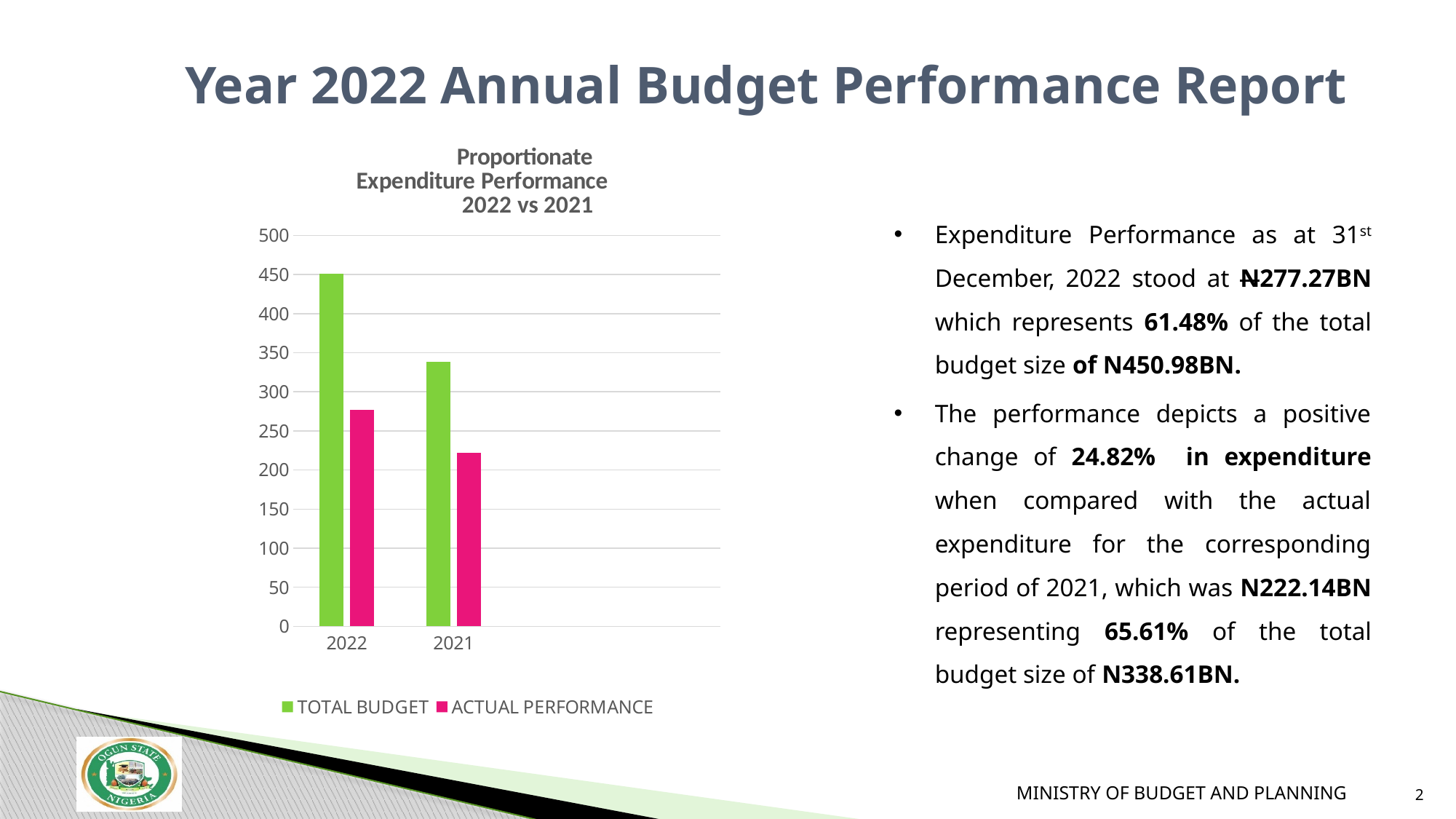
How many year categories are shown on the x axis of the chart? 2 Is the ACTUAL PERFORMANCE value for 2021 greater or less than 250? less Is the ACTUAL PERFORMANCE value for 2022 greater or less than 300? less Which bar in the chart is the shortest? ACTUAL PERFORMANCE for 2021 Is the TOTAL BUDGET value for 2022 greater or less than 400? greater Which colour represents ACTUAL PERFORMANCE in the chart legend? pink What kind of chart is shown on the slide? bar chart How many series does the chart legend list? 2 Does the TOTAL BUDGET series rise or fall moving from 2022 to 2021 along the x axis? fall Which bar in the chart is the tallest? TOTAL BUDGET for 2022 Which year has the larger ACTUAL PERFORMANCE bar, 2022 or 2021? 2022